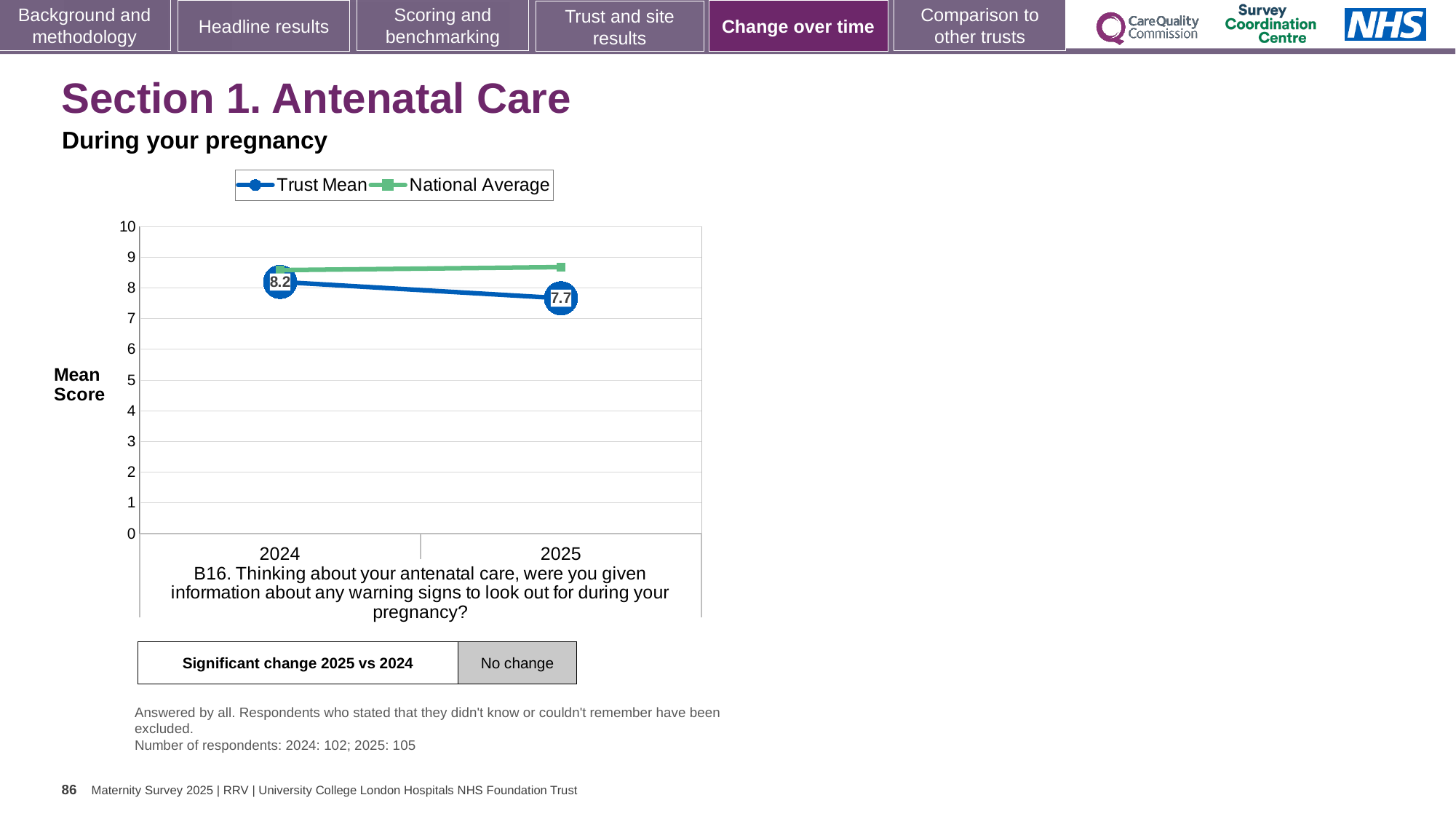
How many years are plotted on the x axis? 2 Does the Trust Mean rise or fall from 2024 to 2025? fall What is the Trust Mean score for 2024? 8.2 In which year is the Trust Mean score lowest? 2025 Is the National Average value for 2025 greater or less than 8? greater How many series does the legend list? 2 Is the National Average value for 2024 greater or less than 9? less What kind of chart is shown on the slide? line chart What is the difference between the Trust Mean score in 2024 and in 2025? 0.5 In which year is the Trust Mean score higher? 2024 In 2025, which is larger: the Trust Mean or the National Average? National Average What is the Trust Mean score for 2025? 7.7